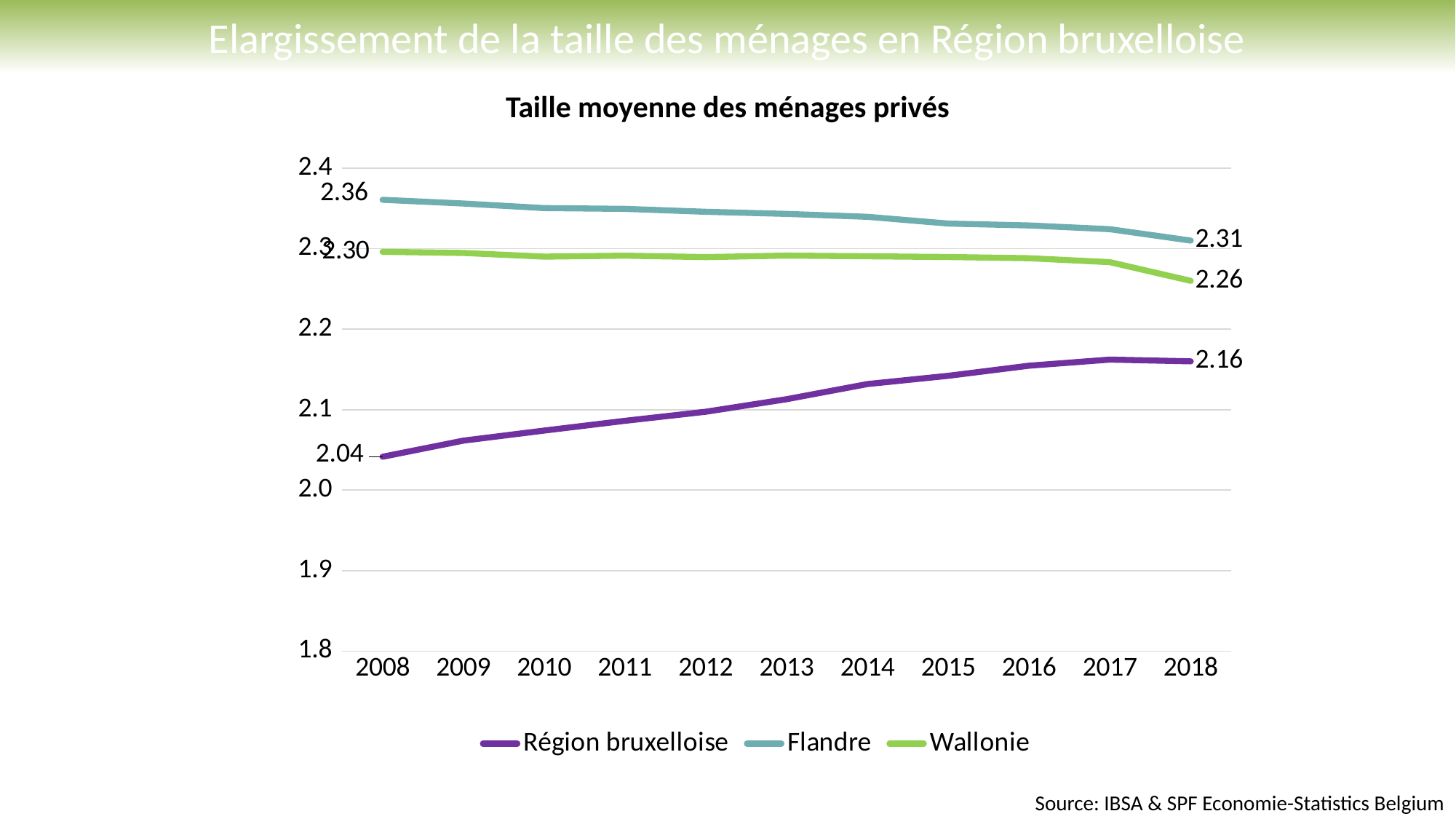
What is the value for Wallonie in 2018? 2.26 How many years are shown on the x axis? 11 Does the value for Région bruxelloise rise or fall from 2008 to 2018? rise How many series does the legend list? 3 Which series has the highest value in 2018? Flandre What is the title of the chart? Taille moyenne des ménages privés What is the value for Région bruxelloise in 2018? 2.16 What is the value for Région bruxelloise in 2008? 2.04 What is the value for Flandre in 2018? 2.31 By how much did the value for Région bruxelloise change between 2008 and 2018? 0.12 Is the value for Flandre in 2013 greater or less than 2.3? greater What kind of chart is shown on the slide? line chart